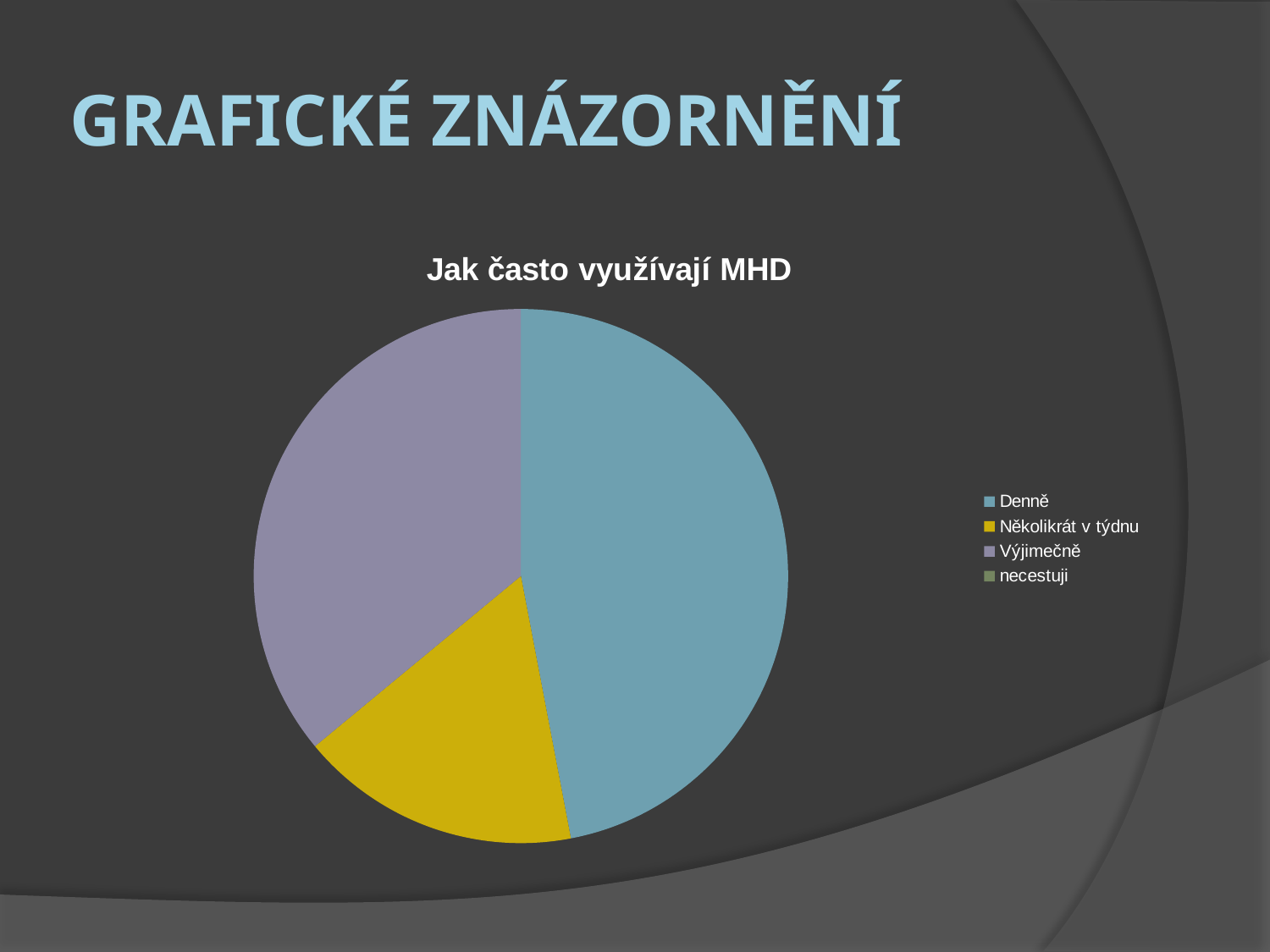
Which legend entry has no visible slice in the pie? necestuji How many slices are visible in the pie? 3 Which is larger, the slice for Denně or the slice for Výjimečně? Denně How many entries does the chart legend list? 4 What is the title of the chart? Jak často využívají MHD Which category has the largest slice of the pie? Denně Which is larger, the slice for Denně or the slice for Několikrát v týdnu? Denně Which is larger, the slice for Výjimečně or the slice for Několikrát v týdnu? Výjimečně What colour is the slice for Několikrát v týdnu? yellow What kind of chart is shown on the slide? pie chart